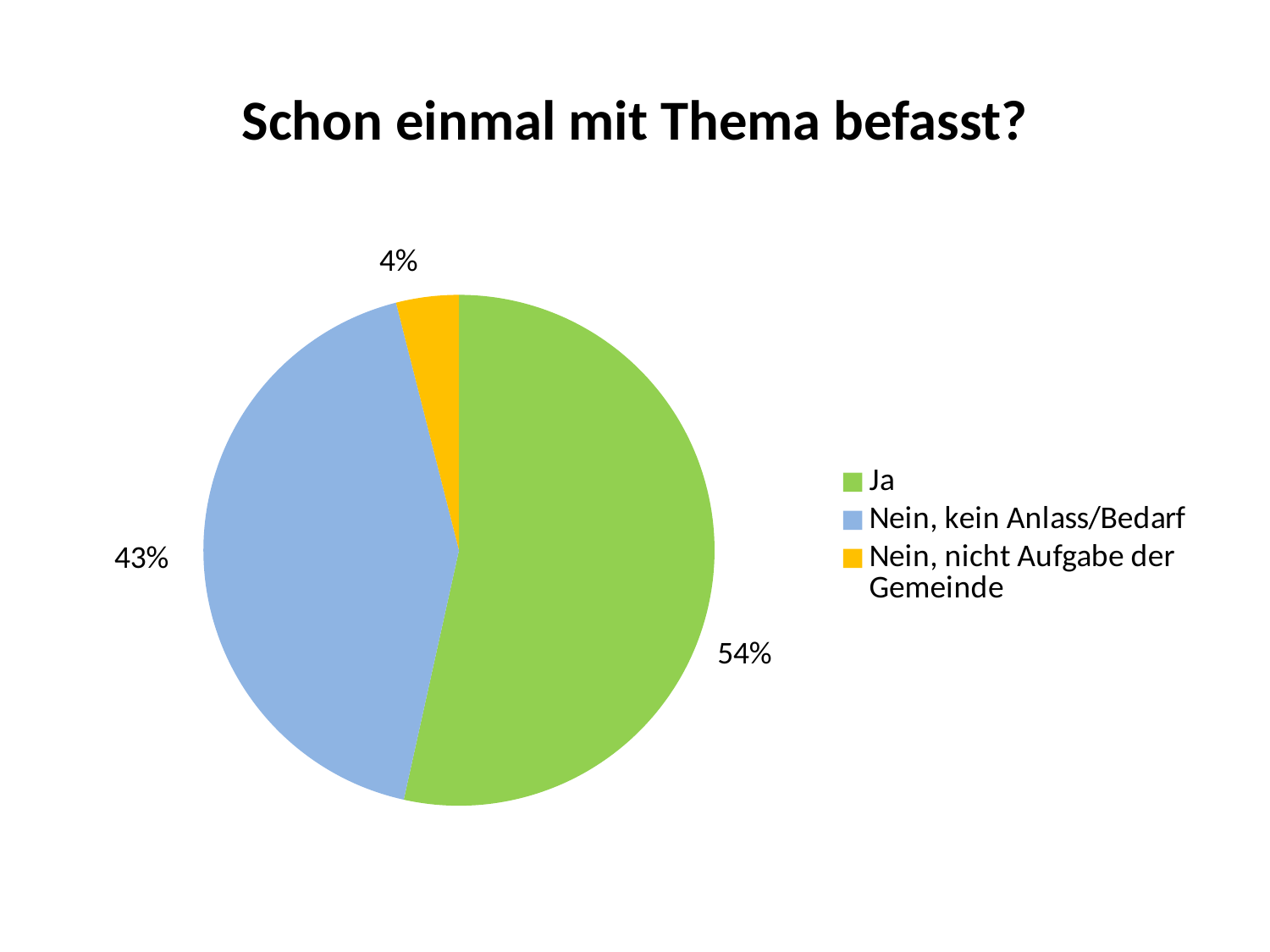
Which is larger, the share for "Ja" or the share for "Nein, kein Anlass/Bedarf"? Ja What share of the pie does "Ja" represent? 54% What is the title of the chart? Schon einmal mit Thema befasst? Which category has the largest slice of the pie? Ja Which category has the smallest slice of the pie? Nein, nicht Aufgabe der Gemeinde What is the difference in percentage points between "Ja" and "Nein, kein Anlass/Bedarf"? 11 percentage points What share of the pie does "Nein, kein Anlass/Bedarf" represent? 43% What kind of chart is shown on the slide? Pie chart What share of the pie does "Nein, nicht Aufgabe der Gemeinde" represent? 4% What is the difference in percentage points between "Nein, kein Anlass/Bedarf" and "Nein, nicht Aufgabe der Gemeinde"? 39 percentage points How many categories are shown in the pie chart? 3 Which colour represents "Nein, kein Anlass/Bedarf" in the chart? Blue